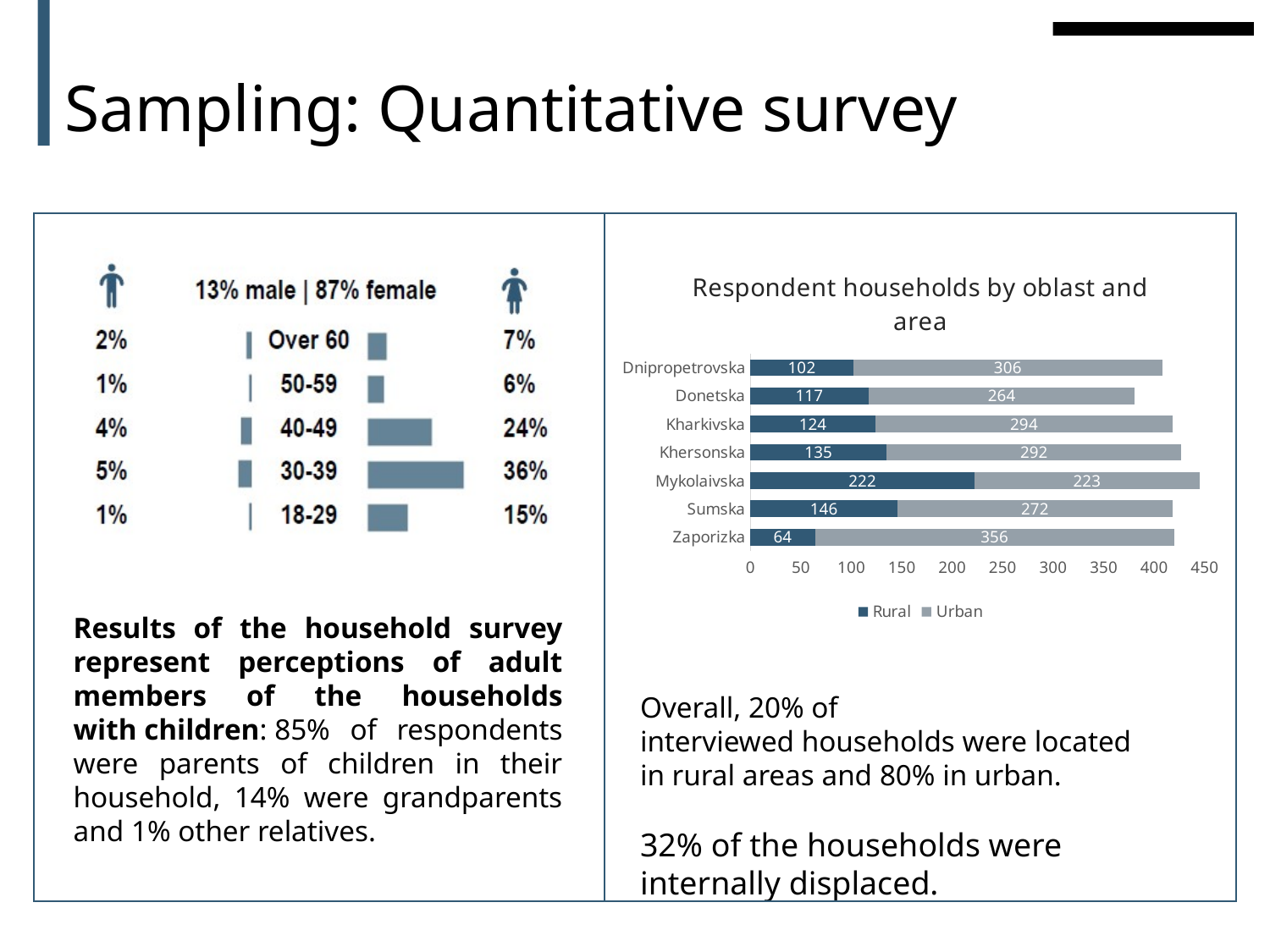
How many series does the legend of the chart 'Respondent households by oblast and area' list? 2 In the chart 'Respondent households by oblast and area', what is the difference between the Urban and Rural values for Donetska? 147 In the chart 'Respondent households by oblast and area', which is larger: the Rural value for Sumska or the Rural value for Khersonska? Sumska In the chart 'Respondent households by oblast and area', which oblast has the lowest Rural value? Zaporizka How many oblasts are shown in the chart 'Respondent households by oblast and area'? 7 In the chart 'Respondent households by oblast and area', what is the Rural value for Kharkivska? 124 In the chart 'Respondent households by oblast and area', what is the total of the stacked bar for Dnipropetrovska? 408 In the chart 'Respondent households by oblast and area', which oblast has the highest Rural value? Mykolaivska In the chart 'Respondent households by oblast and area', what is the Urban value for Zaporizka? 356 In the chart 'Respondent households by oblast and area', what is the total of the stacked bar for Mykolaivska? 445 What kind of chart is 'Respondent households by oblast and area'? Stacked bar chart In the chart 'Respondent households by oblast and area', which oblast has the lowest Urban value? Mykolaivska